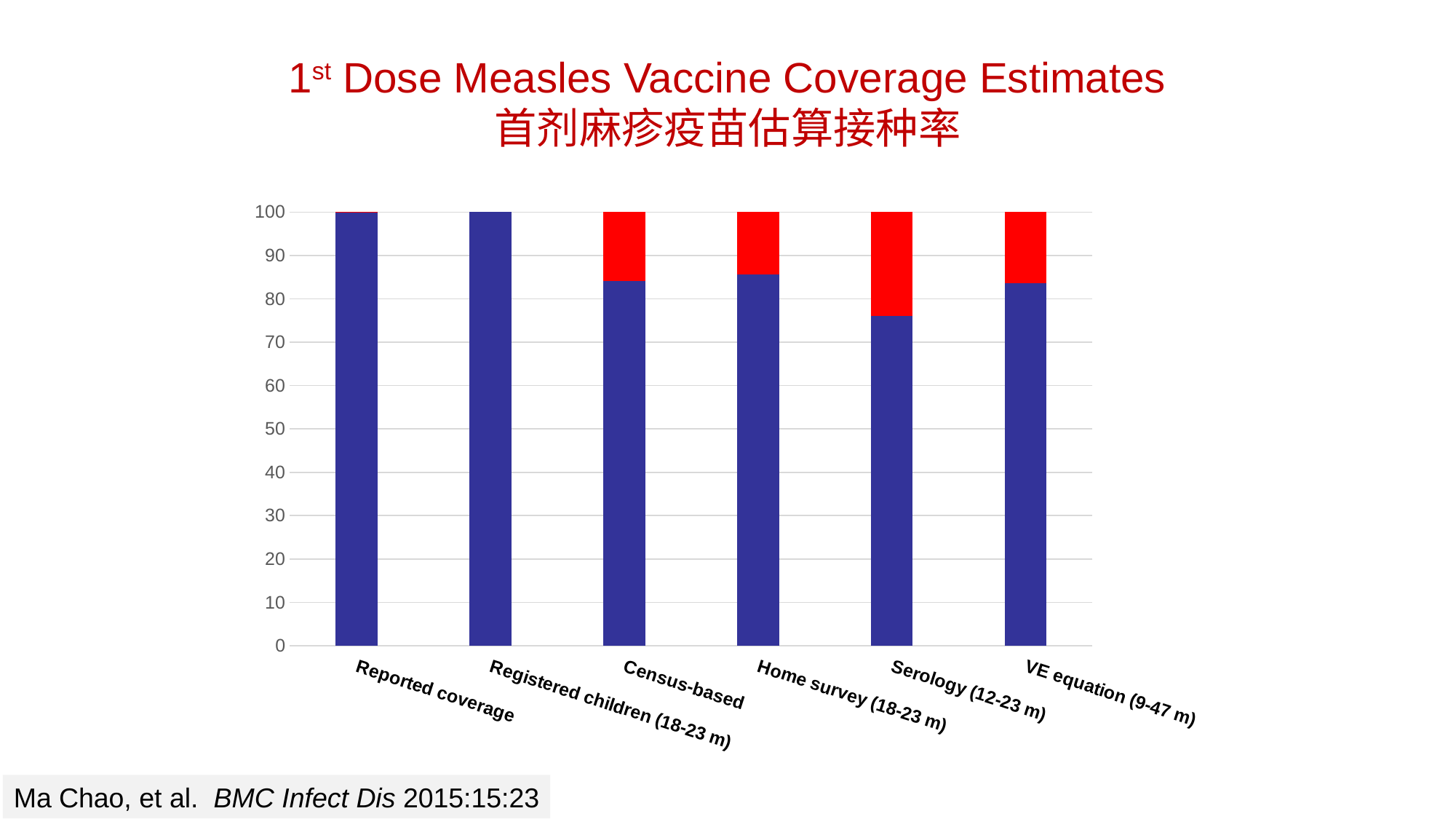
What is the total height of the stacked bar for Serology (12-23 m)? 100 What is the title of the chart on the slide (English part)? 1st Dose Measles Vaccine Coverage Estimates Which has the larger blue segment, Census-based or Serology (12-23 m)? Census-based Is the blue segment for Serology (12-23 m) greater or less than 80? less What value does the bar for Registered children (18-23 m) reach? 100 What kind of chart is shown on the slide? Stacked bar chart Is the blue segment for Home survey (18-23 m) greater or less than 90? less Is the blue segment for Census-based greater or less than 80? greater How many categories are shown along the x axis of the chart? 6 Which category has the smallest blue segment? Serology (12-23 m) What value does the bar for Reported coverage reach? 100 Which category has the largest red segment? Serology (12-23 m)